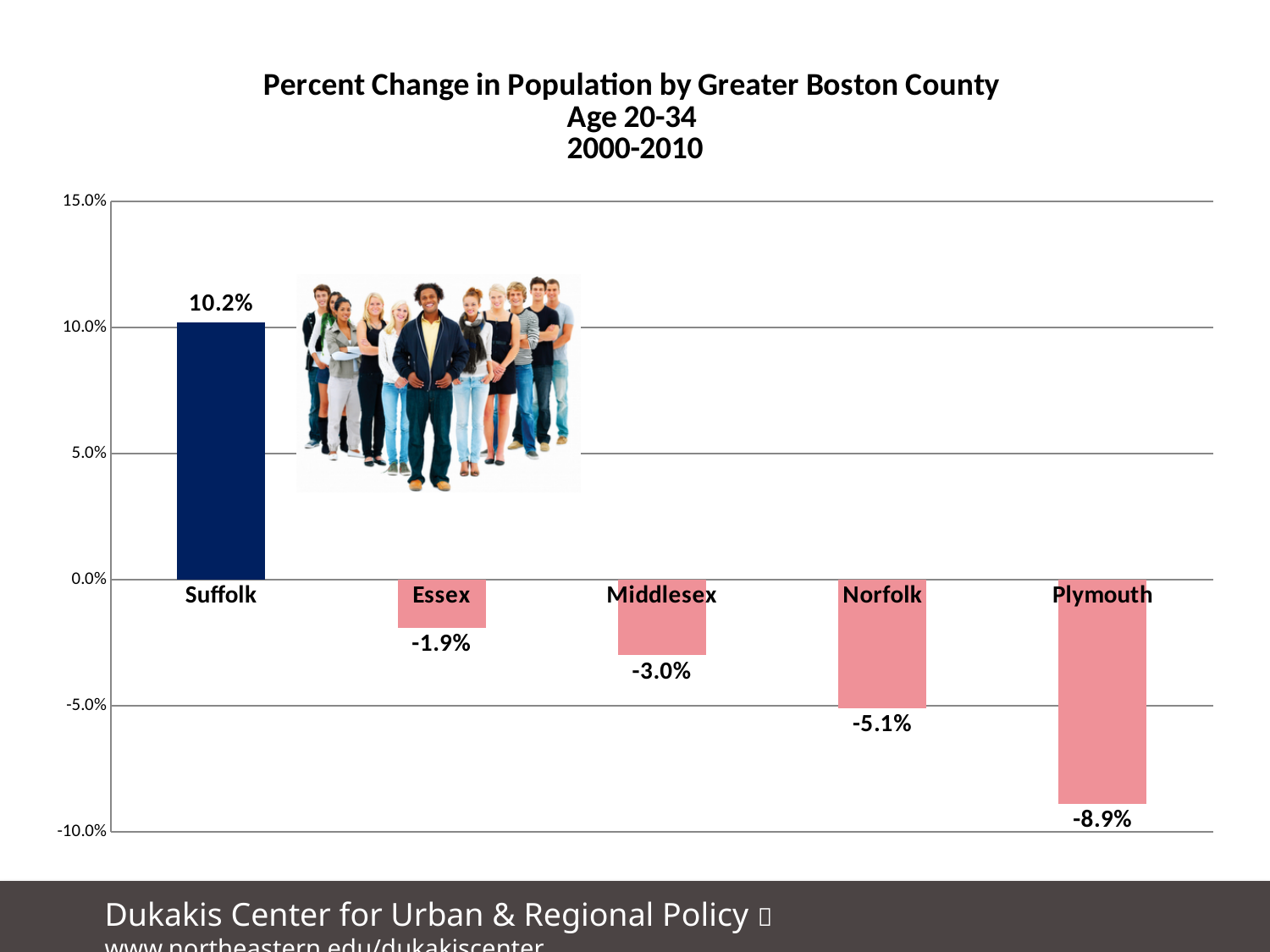
How many counties are shown in the chart? 5 Which county has the lowest percent change in population? Plymouth What is the difference between the percent change for Suffolk and Plymouth? 19.1 percentage points What is the percent change in population for Suffolk? 10.2% Which county has the highest percent change in population? Suffolk What age group does the chart cover? Age 20-34 What is the percent change in population for Plymouth? -8.9% What kind of chart is shown on the slide? Bar chart What is the percent change in population for Middlesex? -3.0% What is the difference between the percent change for Essex and Norfolk? 3.2 percentage points Which county has a larger percent change in population, Essex or Middlesex? Essex What is the percent change in population for Norfolk? -5.1%